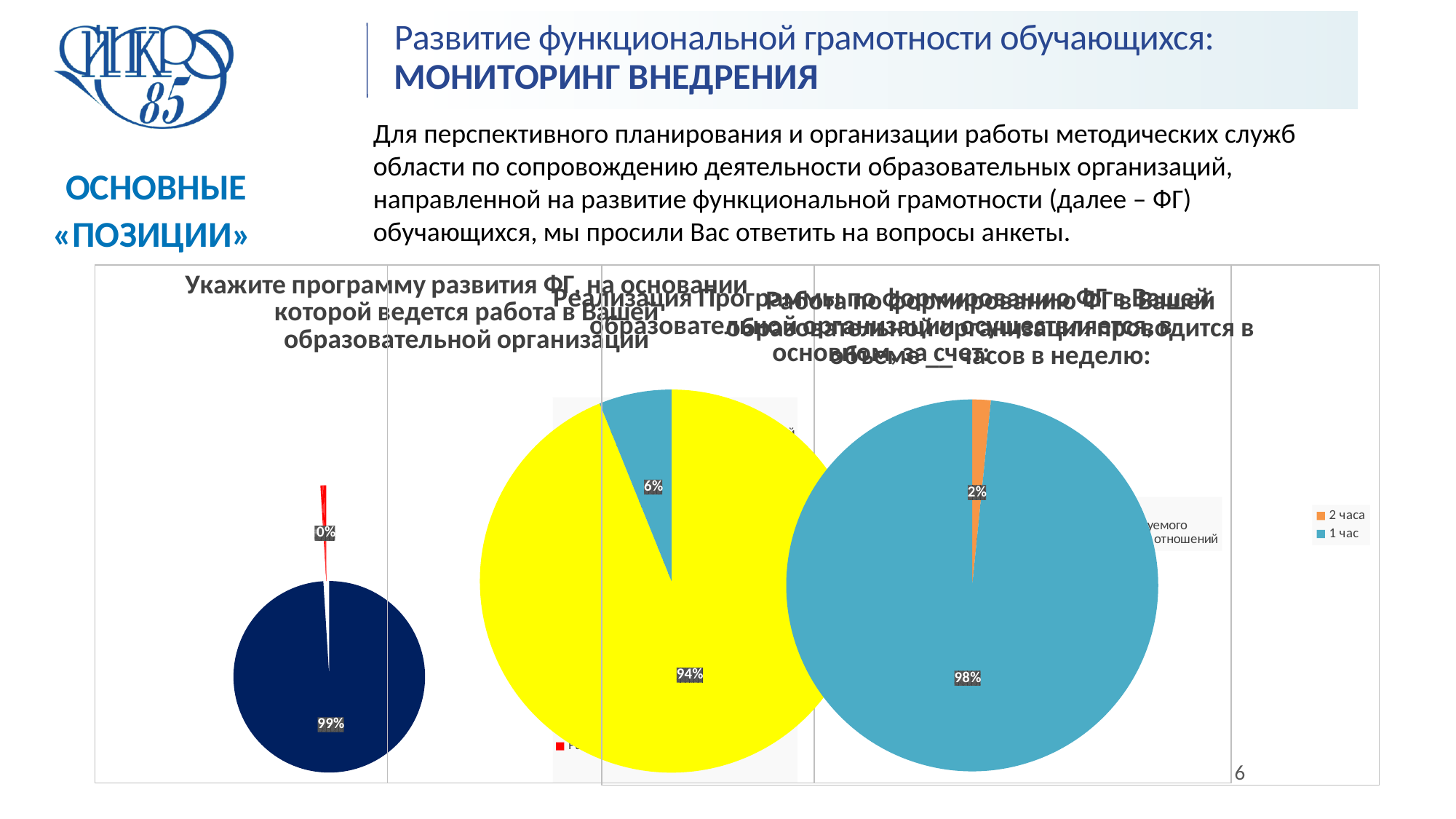
In the middle pie chart, what is the difference between the yellow slice and the teal slice? 88% What kind of chart is the leftmost chart on the slide? pie chart In the middle pie chart, what percentage is shown on the teal slice? 6% In the leftmost pie chart, what percentage is shown on the large dark blue slice? 99% In the rightmost pie chart, which category has the smallest share? 2 часа In the rightmost pie chart, what share is labelled for '1 час'? 98% In the rightmost pie chart, what share is labelled for '2 часа'? 2% In the leftmost pie chart, what percentage is shown on the small red slice? 0% In the rightmost pie chart, which category has the largest share? 1 час How many entries does the legend of the rightmost pie chart list? 2 In the middle pie chart, what percentage is shown on the yellow slice? 94% How many pie charts are shown on the slide? 3